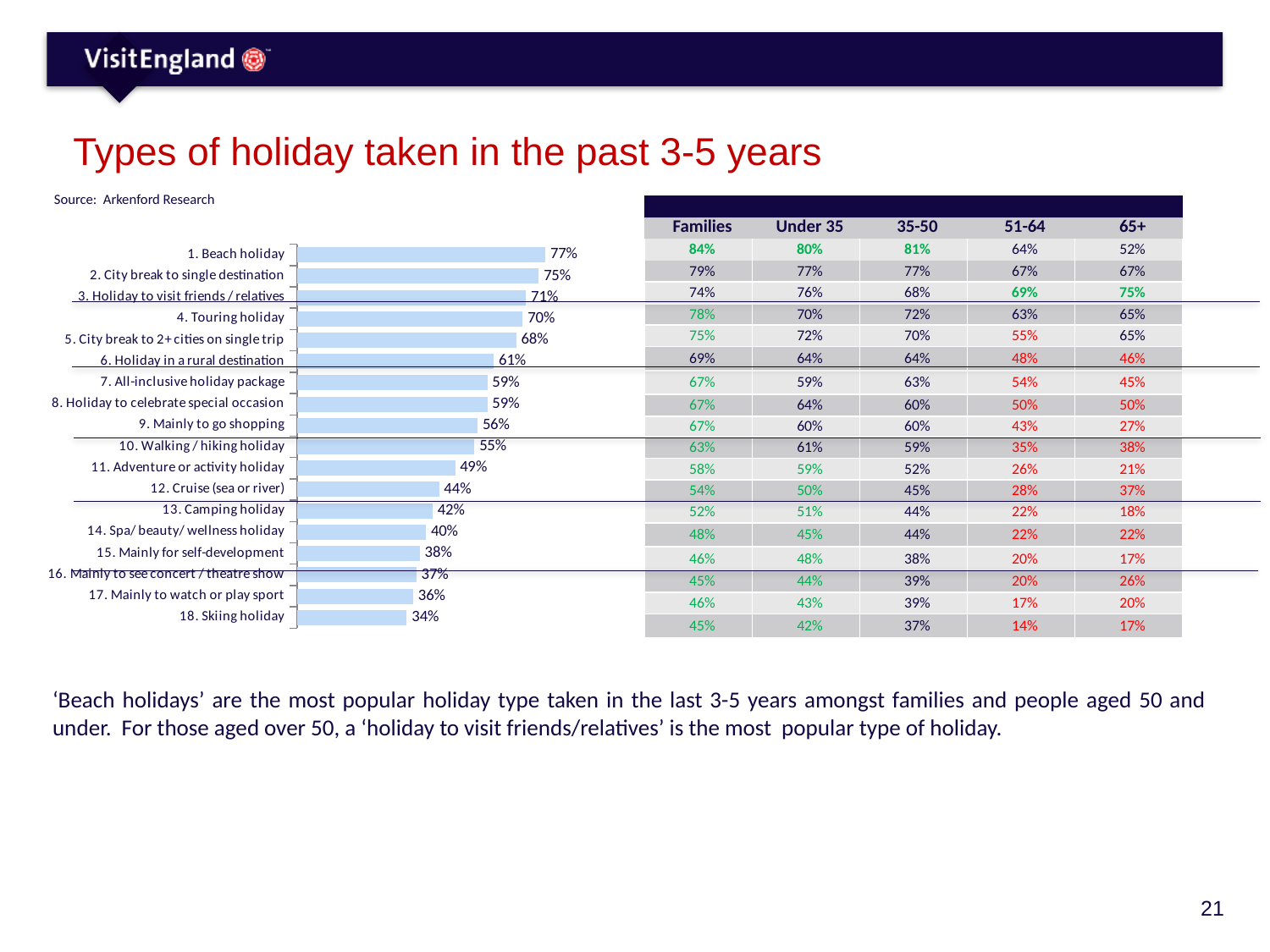
In the bar chart, which is larger: '13. Camping holiday' or '11. Adventure or activity holiday'? 11. Adventure or activity holiday How many holiday types are listed in the bar chart? 18 Do the values in the bar chart increase or decrease from the top category to the bottom category? Decrease Which holiday type has the lowest value in the bar chart? 18. Skiing holiday What kind of chart is used to show the types of holiday taken? Bar chart What is the difference between '4. Touring holiday' and '6. Holiday in a rural destination' in the bar chart? 9% What percentage is shown for '9. Mainly to go shopping' in the bar chart? 56% What is the difference between the values for '1. Beach holiday' and '18. Skiing holiday' in the bar chart? 43% Which holiday type has the highest value in the bar chart? 1. Beach holiday What value does the bar chart show for '12. Cruise (sea or river)'? 44% What percentage is shown for '1. Beach holiday' in the bar chart? 77% What is the title of the slide containing the bar chart? Types of holiday taken in the past 3-5 years